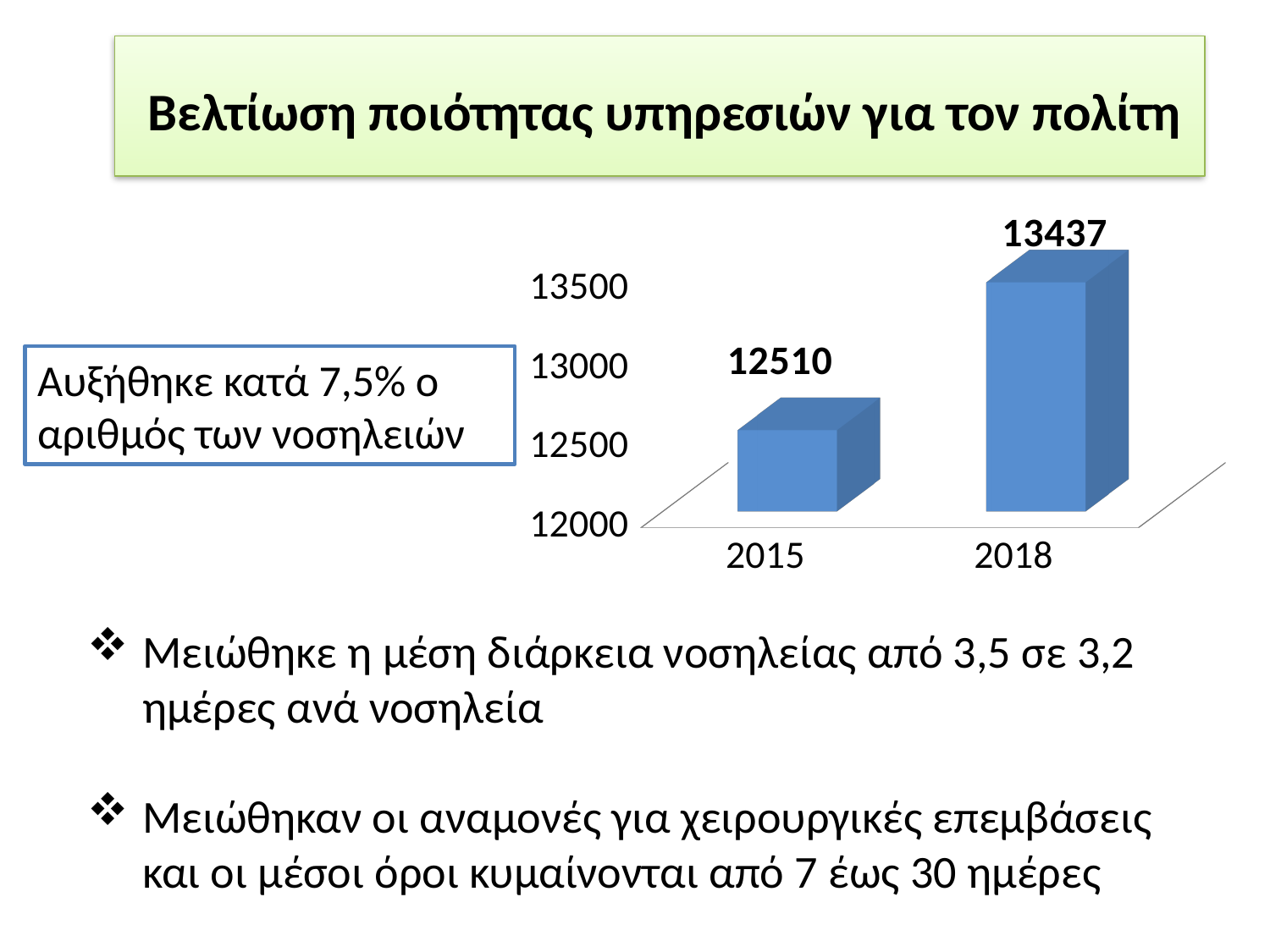
What is the value for 2015? 12510 Which year has the highest value? 2018 What is the value for 2018? 13437 Which is larger, the value for 2015 or the value for 2018? 2018 What is the difference between the values for 2018 and 2015? 927 What is the lowest value shown on the vertical axis? 12000 Is the value for 2018 greater or less than 13000? greater Is the value for 2015 greater or less than 13000? less Which year has the lowest value? 2015 What kind of chart is shown on the slide? bar chart How many categories are shown on the x axis? 2 Do the values rise or fall from 2015 to 2018? rise